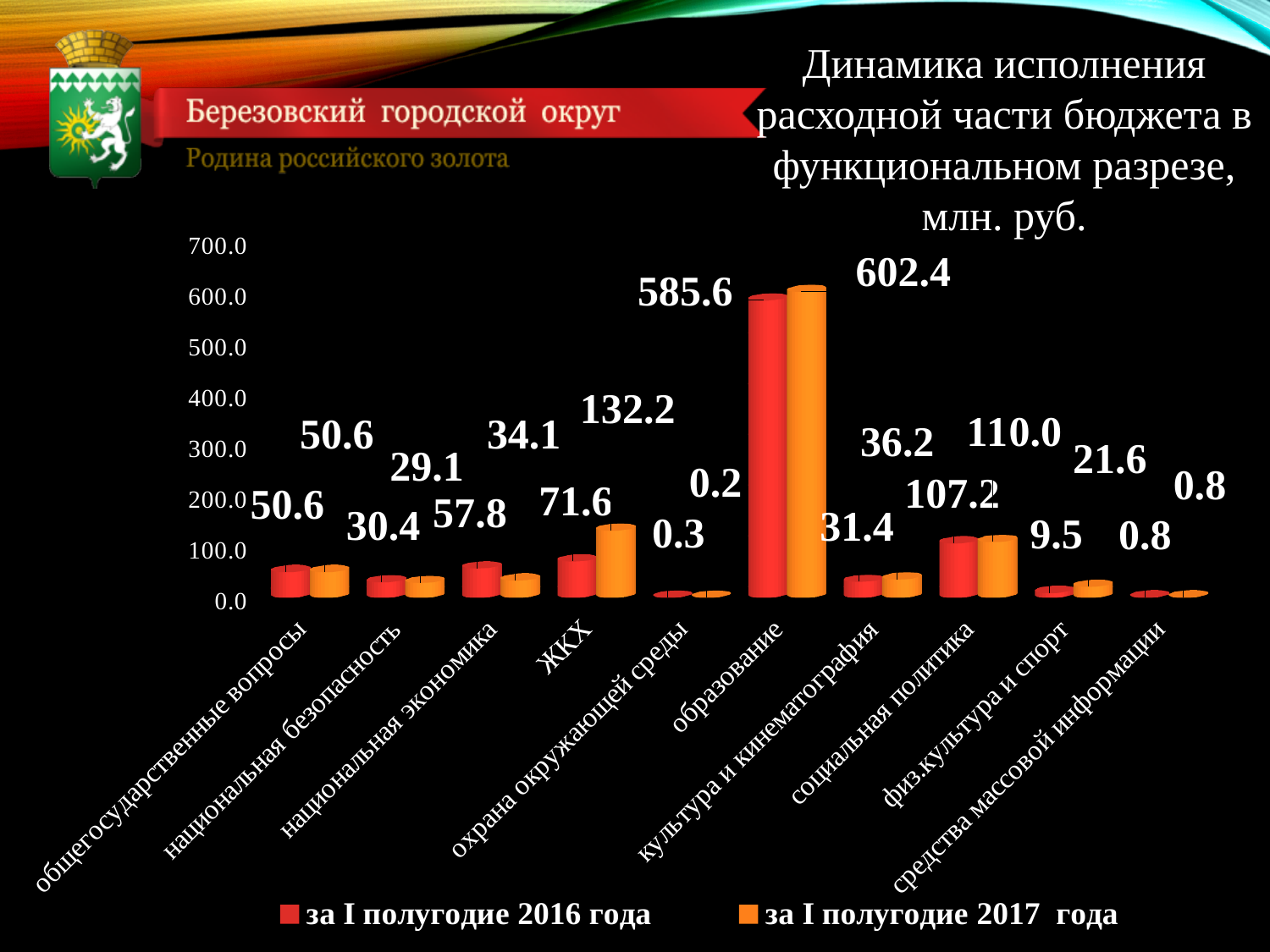
For национальная экономика, which is larger: the value for за I полугодие 2016 года or за I полугодие 2017 года? за I полугодие 2016 года Which category has the lowest value for за I полугодие 2017 года? охрана окружающей среды What is the value for физ.культура и спорт for за I полугодие 2017 года? 21.6 What is the unit of measurement stated in the chart title? млн. руб. How many series does the legend list? 2 What is the value for ЖКХ for за I полугодие 2016 года? 71.6 What kind of chart is shown on the slide? bar chart What is the value for образование for за I полугодие 2017 года? 602.4 Which category has the highest value for за I полугодие 2016 года? образование How many categories are shown on the x axis? 10 Is the value for социальная политика for за I полугодие 2017 года greater or less than 200.0? less What is the difference between the 2017 and 2016 values for ЖКХ? 60.6